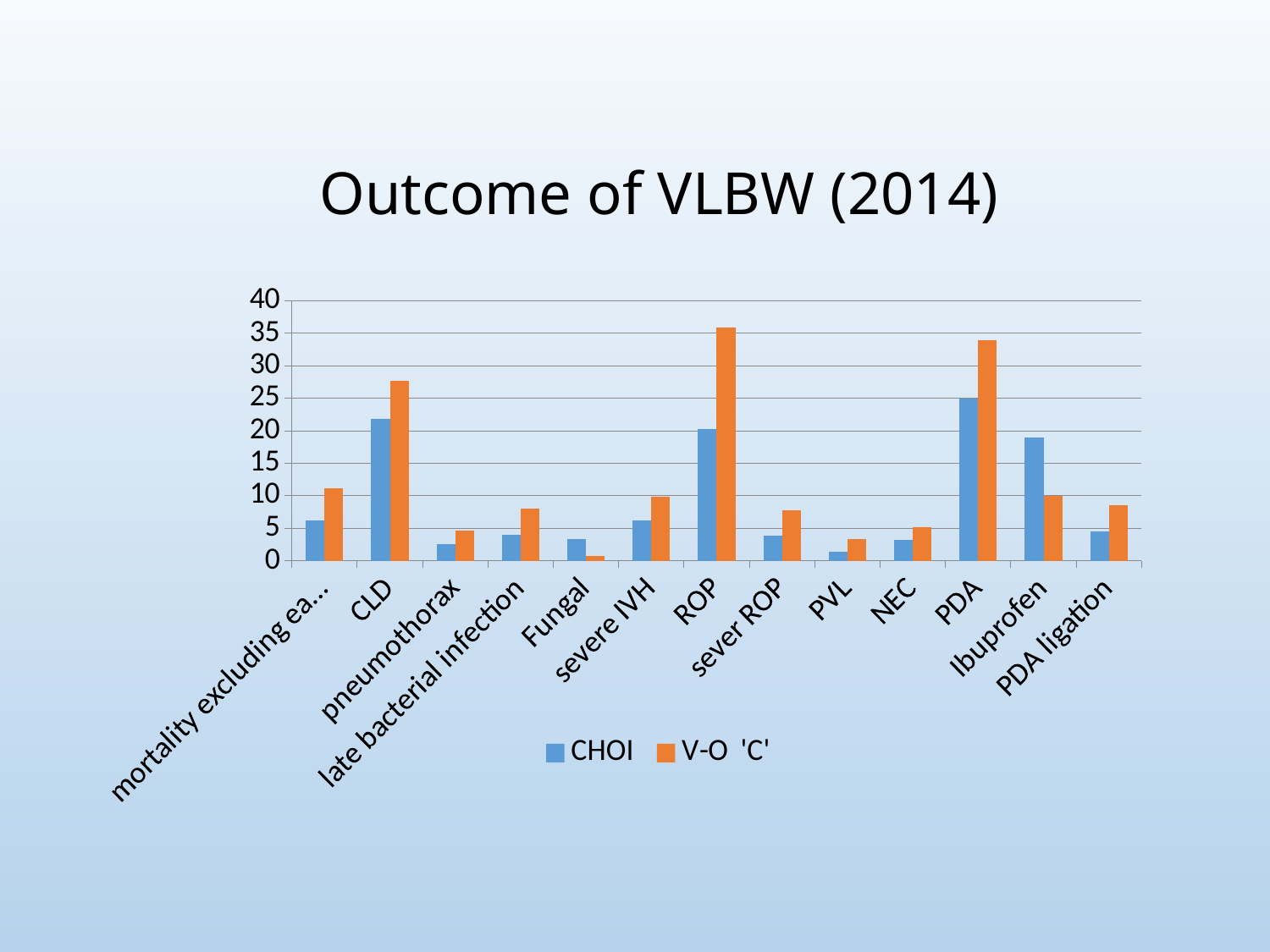
Is the CHOI value for CLD greater or less than 20? greater For ROP, which series has the larger value, CHOI or V-O 'C'? V-O 'C' Which category has the highest value for the V-O 'C' series? ROP Which category has the lowest value for the V-O 'C' series? Fungal How many series does the legend list? 2 Which category has the highest value for the CHOI series? PDA For Ibuprofen, which series has the larger value, CHOI or V-O 'C'? CHOI What is the title of the chart? Outcome of VLBW (2014) How many categories are shown on the x axis? 13 Which category has the lowest value for the CHOI series? PVL What type of chart is shown on the slide? bar chart Is the V-O 'C' value for ROP greater or less than 30? greater